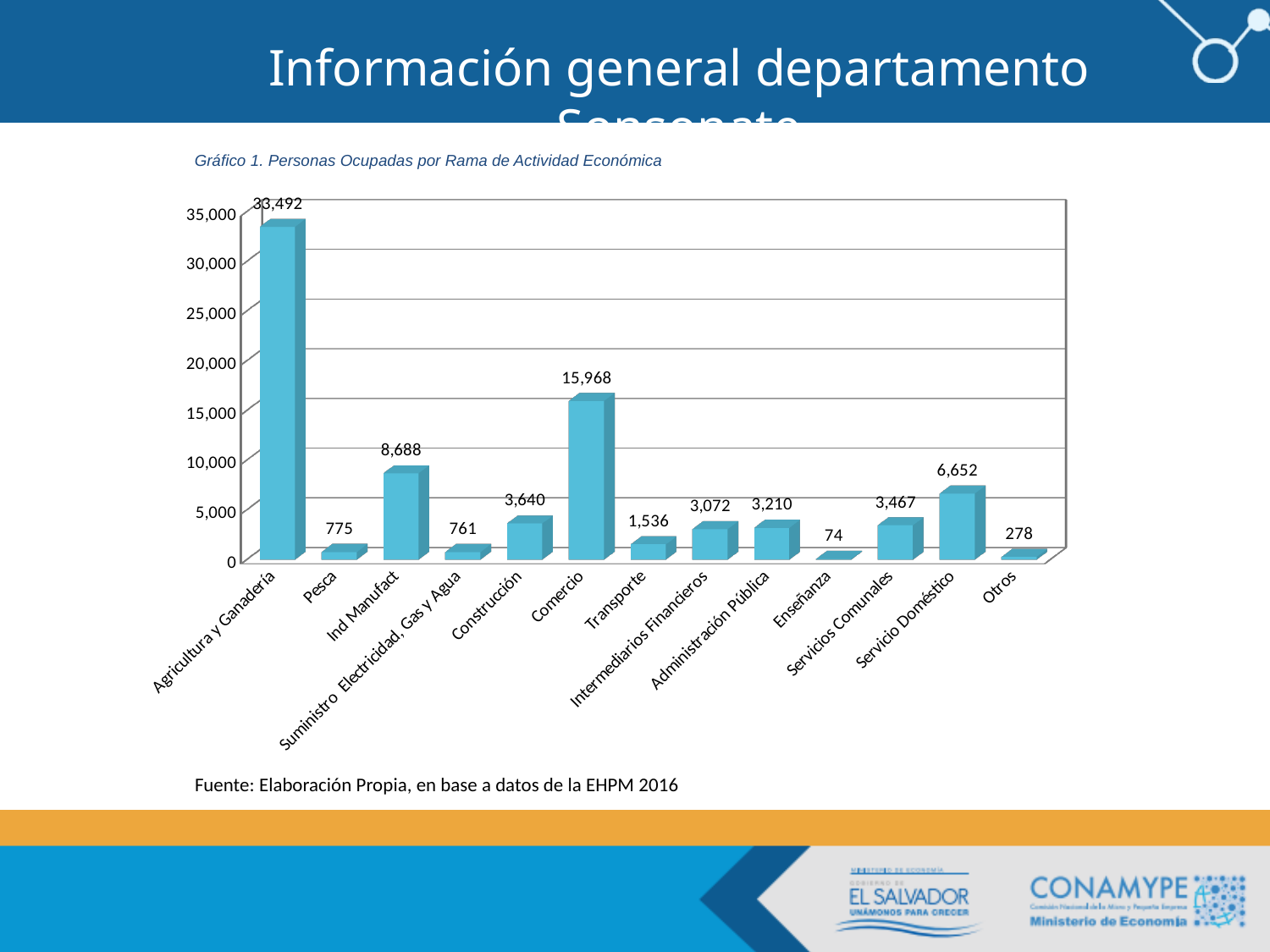
What is the title of the chart? Gráfico 1. Personas Ocupadas por Rama de Actividad Económica What is the value for Agricultura y Ganadería? 33,492 Which category has the lowest value? Enseñanza Which is larger, Administración Pública or Intermediarios Financieros? Administración Pública What is the difference between Ind Manufact and Construcción? 5,048 What is the value for Comercio? 15,968 How many categories are shown on the x axis? 13 What is the value for Servicio Doméstico? 6,652 What is the value for Enseñanza? 74 Which category has the highest value? Agricultura y Ganadería What kind of chart is shown? Bar chart What is the difference between Agricultura y Ganadería and Comercio? 17,524